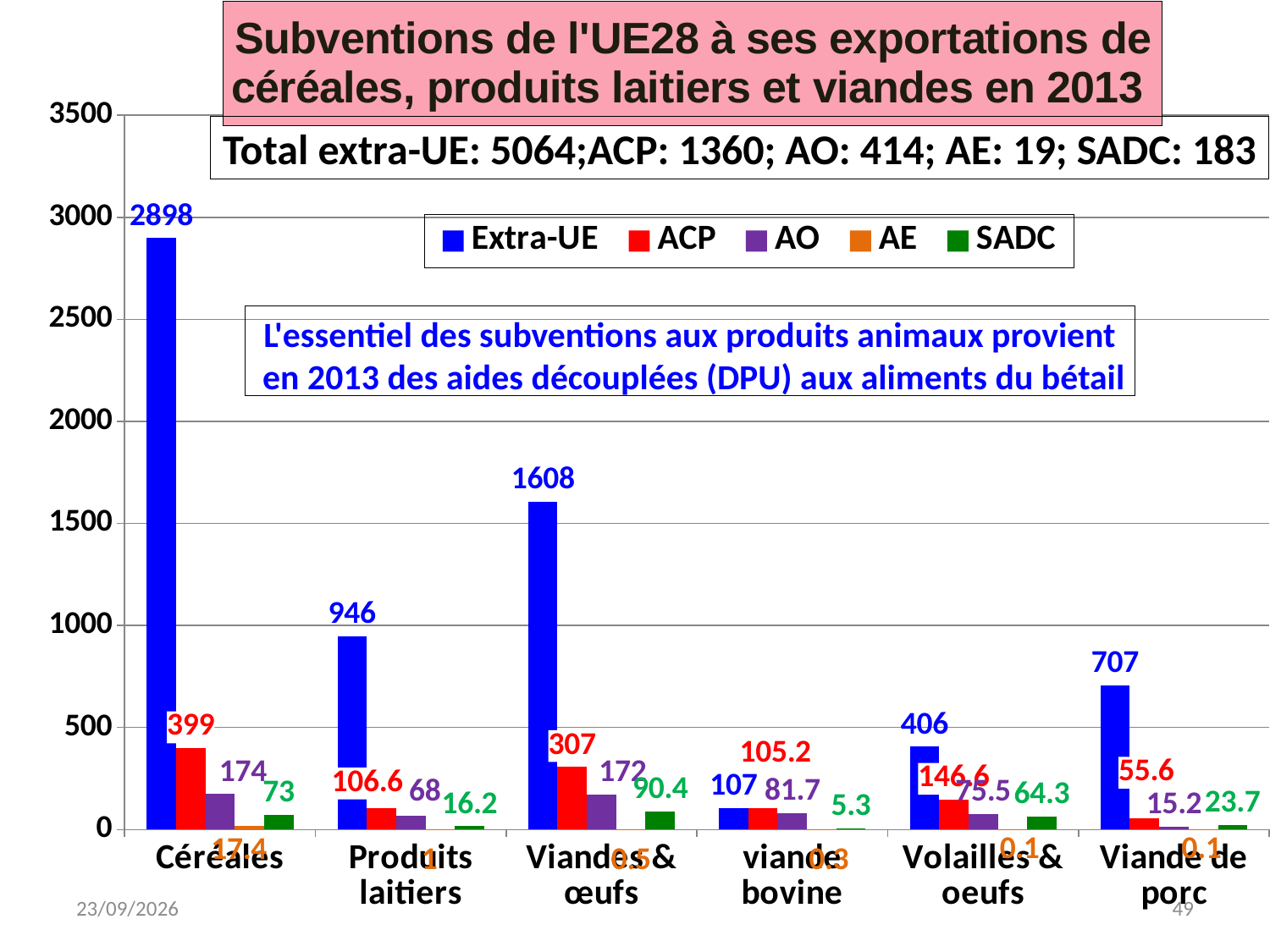
What is the Extra-UE value for Céréales? 2898 Is the Extra-UE value for Produits laitiers greater or less than 1000? less How many series does the legend list? 5 What is the difference between the Extra-UE values for Céréales and Viandes & œufs? 1290 What is the AO value for viande bovine? 81.7 What is the ACP value for Viandes & œufs? 307 What kind of chart is shown on the slide? bar chart Which is larger: the ACP value for Céréales or the ACP value for Volailles & oeufs? Céréales Which category has the highest Extra-UE value? Céréales What is the SADC value for Viande de porc? 23.7 Which category has the lowest Extra-UE value? viande bovine How many product categories are shown on the x axis? 6